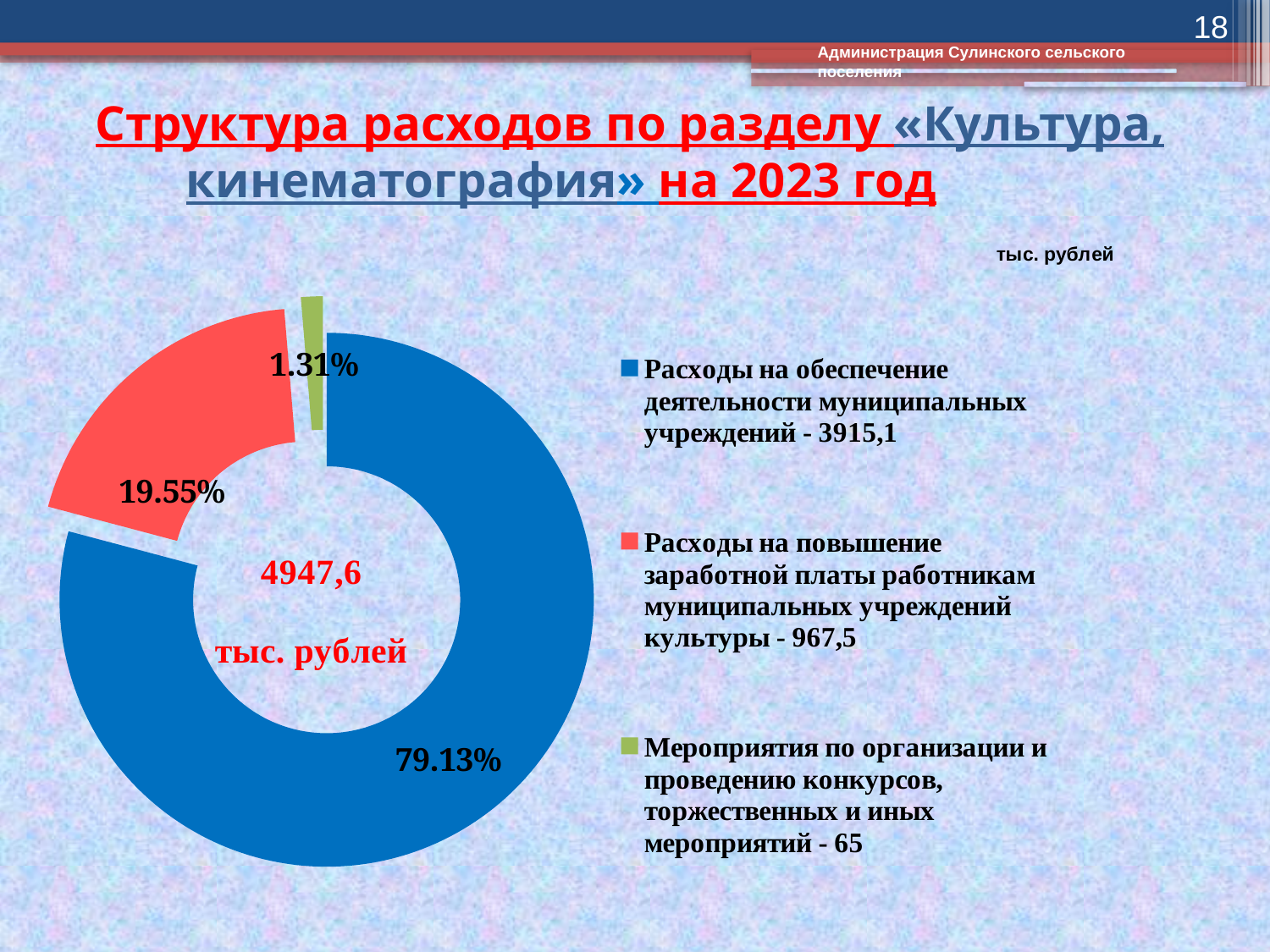
What is the value (тыс. рублей) for «Расходы на повышение заработной платы работникам муниципальных учреждений культуры»? 967,5 How many slices does the chart have? 3 What share of the chart is taken by «Мероприятия по организации и проведению конкурсов, торжественных и иных мероприятий»? 1.31% What share of the chart is taken by «Расходы на обеспечение деятельности муниципальных учреждений»? 79.13% What share of the chart is taken by «Расходы на повышение заработной платы работникам муниципальных учреждений культуры»? 19.55% Which category has the largest share of the chart? Расходы на обеспечение деятельности муниципальных учреждений How many entries does the legend list? 3 What is the value (тыс. рублей) for «Расходы на обеспечение деятельности муниципальных учреждений»? 3915,1 Which category has the smallest share of the chart? Мероприятия по организации и проведению конкурсов, торжественных и иных мероприятий What total amount (тыс. рублей) is shown in the centre of the chart? 4947,6 What kind of chart is shown on the slide? Doughnut (pie) chart What is the value (тыс. рублей) for «Мероприятия по организации и проведению конкурсов, торжественных и иных мероприятий»? 65